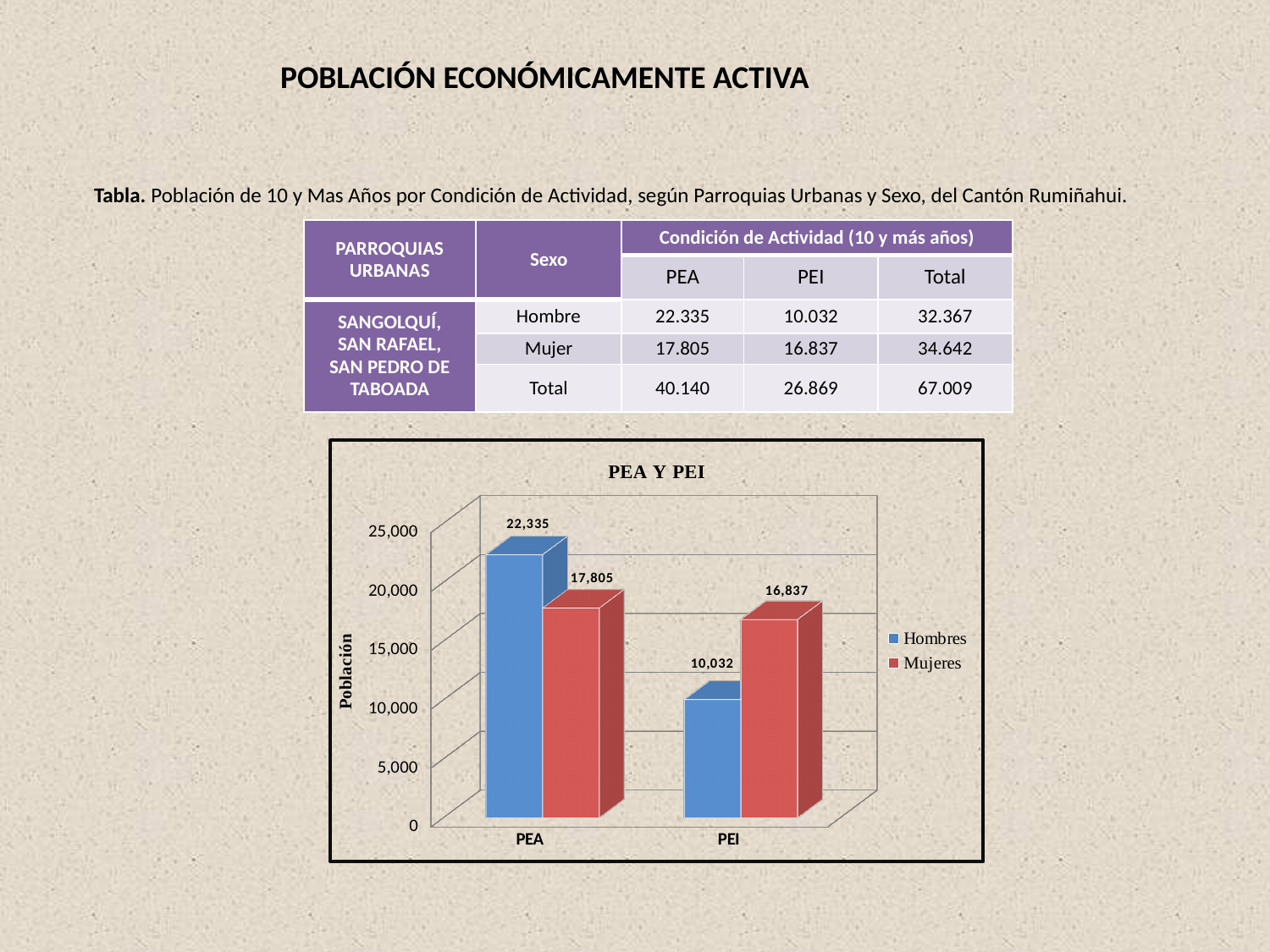
How many series does the legend list? 2 In the PEI category, which is larger, Hombres or Mujeres? Mujeres What is the value for Mujeres in the PEI category? 16,837 Which bar has the lowest value in the chart? Hombres, PEI What is the difference between Hombres and Mujeres in the PEA category? 4,530 What is the difference between Mujeres and Hombres in the PEI category? 6,805 Which bar has the highest value in the chart? Hombres, PEA What is the value for Hombres in the PEI category? 10,032 How many categories are shown on the x axis? 2 What is the title of the chart? PEA Y PEI What is the value for Mujeres in the PEA category? 17,805 What is the value for Hombres in the PEA category? 22,335